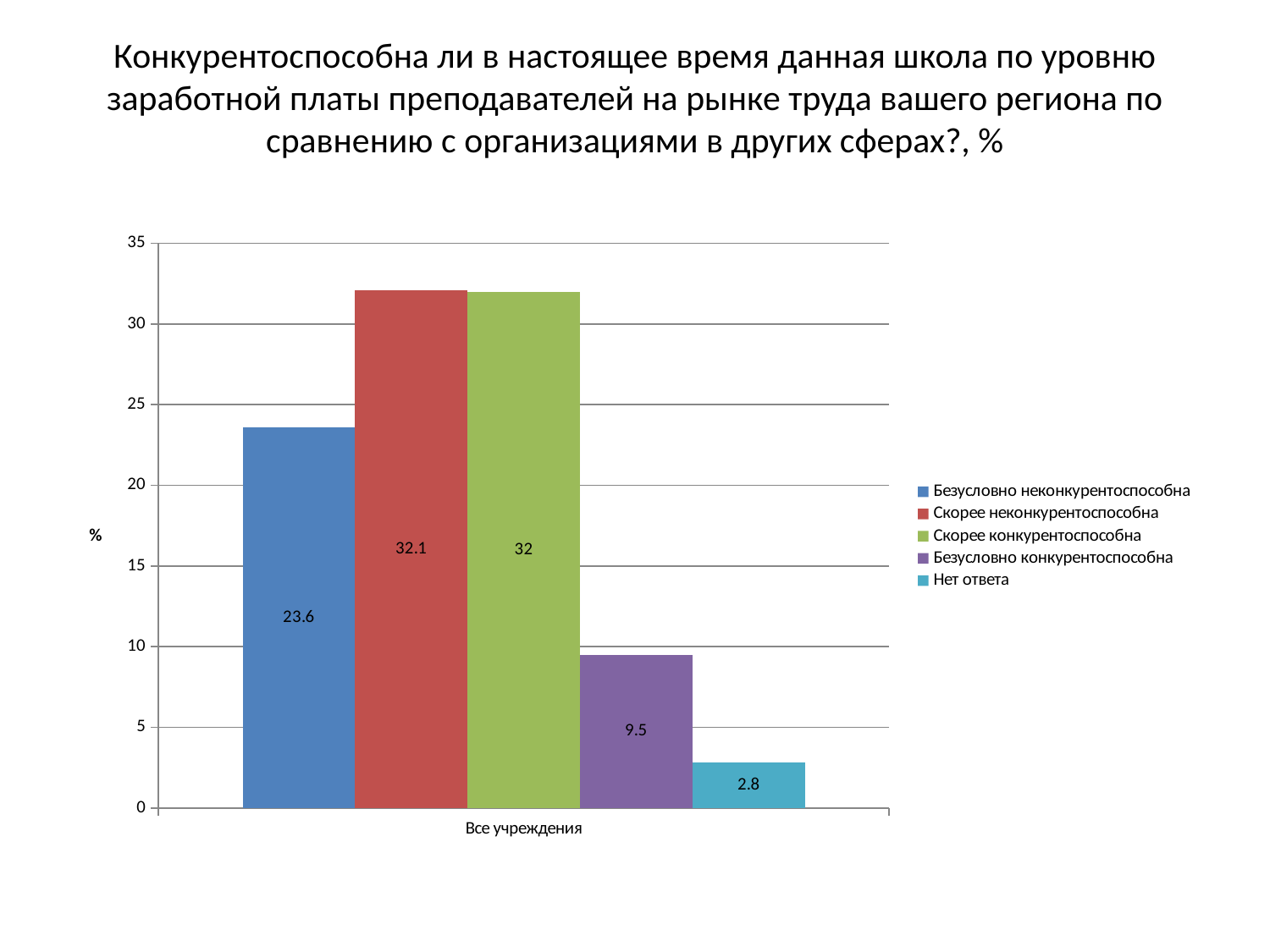
What is the value for "Скорее неконкурентоспособна"? 32.1 What is the difference between the values for "Скорее конкурентоспособна" and "Нет ответа"? 29.2 Which is larger: the value for "Безусловно неконкурентоспособна" or the value for "Безусловно конкурентоспособна"? Безусловно неконкурентоспособна What kind of chart is shown on the slide? bar chart What is the value for "Безусловно неконкурентоспособна"? 23.6 Which series has the lowest value? Нет ответа What is the category label shown on the x axis? Все учреждения How many series does the legend list? 5 What is the value for "Безусловно конкурентоспособна"? 9.5 What is the difference between the values for "Безусловно неконкурентоспособна" and "Безусловно конкурентоспособна"? 14.1 What is the value for "Нет ответа"? 2.8 Is the value for "Скорее конкурентоспособна" greater or less than 30? greater